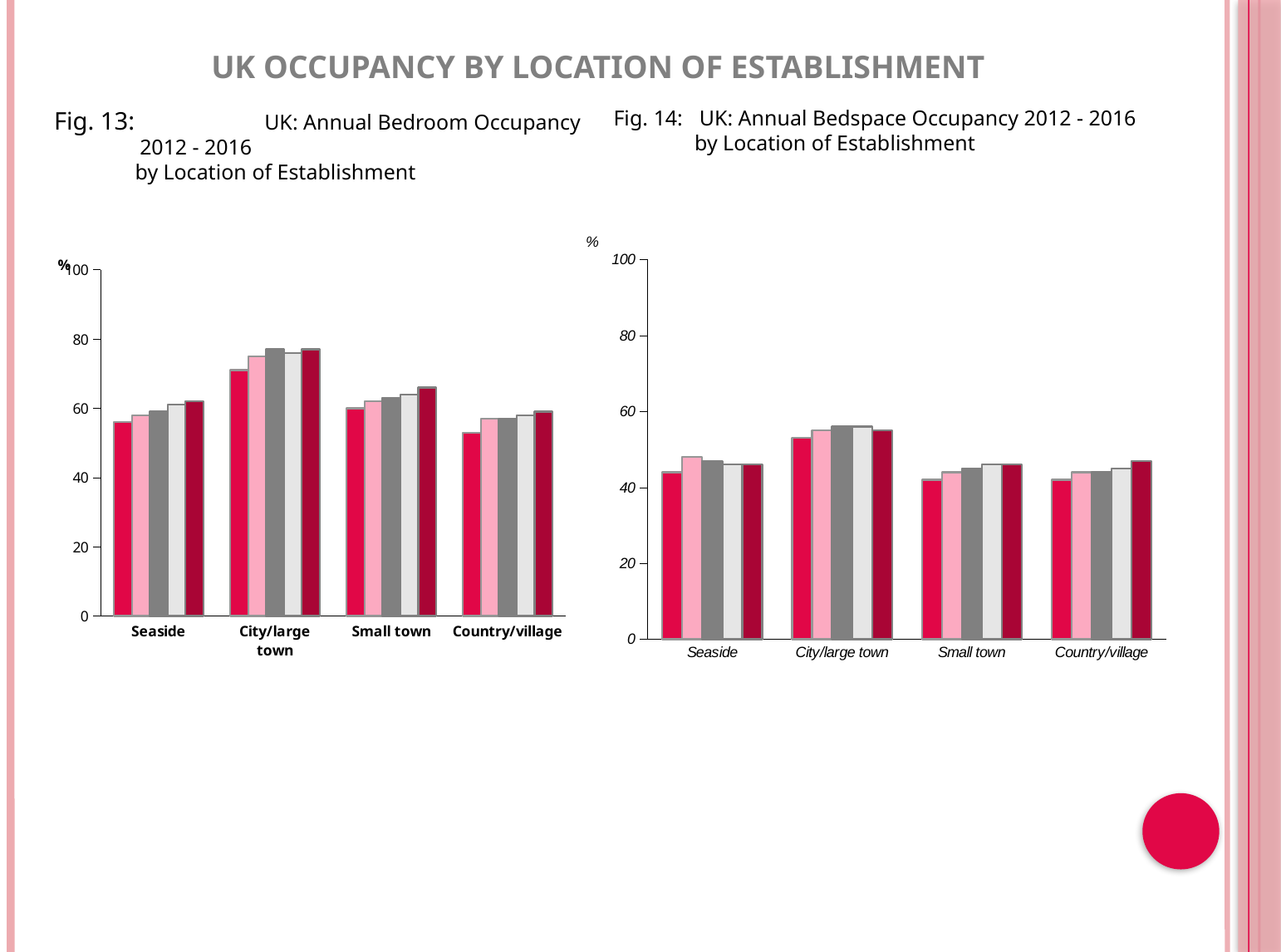
How many bars are plotted for each location category in Fig. 14? 5 In Fig. 13, which location category has the lowest bedroom occupancy bars? Country/village In Fig. 13, which location category has the highest bedroom occupancy bars? City/large town In Fig. 14, which has higher bedspace occupancy bars, City/large town or Small town? City/large town In Fig. 14, are the bars for Seaside greater or less than 60? less How many location categories are shown on the x axis of Fig. 13? 4 What kind of chart is Fig. 13 (UK: Annual Bedroom Occupancy 2012 - 2016 by Location of Establishment)? Bar chart In Fig. 14, are the bars for Small town greater or less than 20? greater In Fig. 14, which location category has the highest bedspace occupancy bars? City/large town What kind of chart is Fig. 14 (UK: Annual Bedspace Occupancy 2012 - 2016 by Location of Establishment)? Bar chart In Fig. 13, are the bars for City/large town greater or less than 60? greater What unit is shown on the y axis of Fig. 14? %